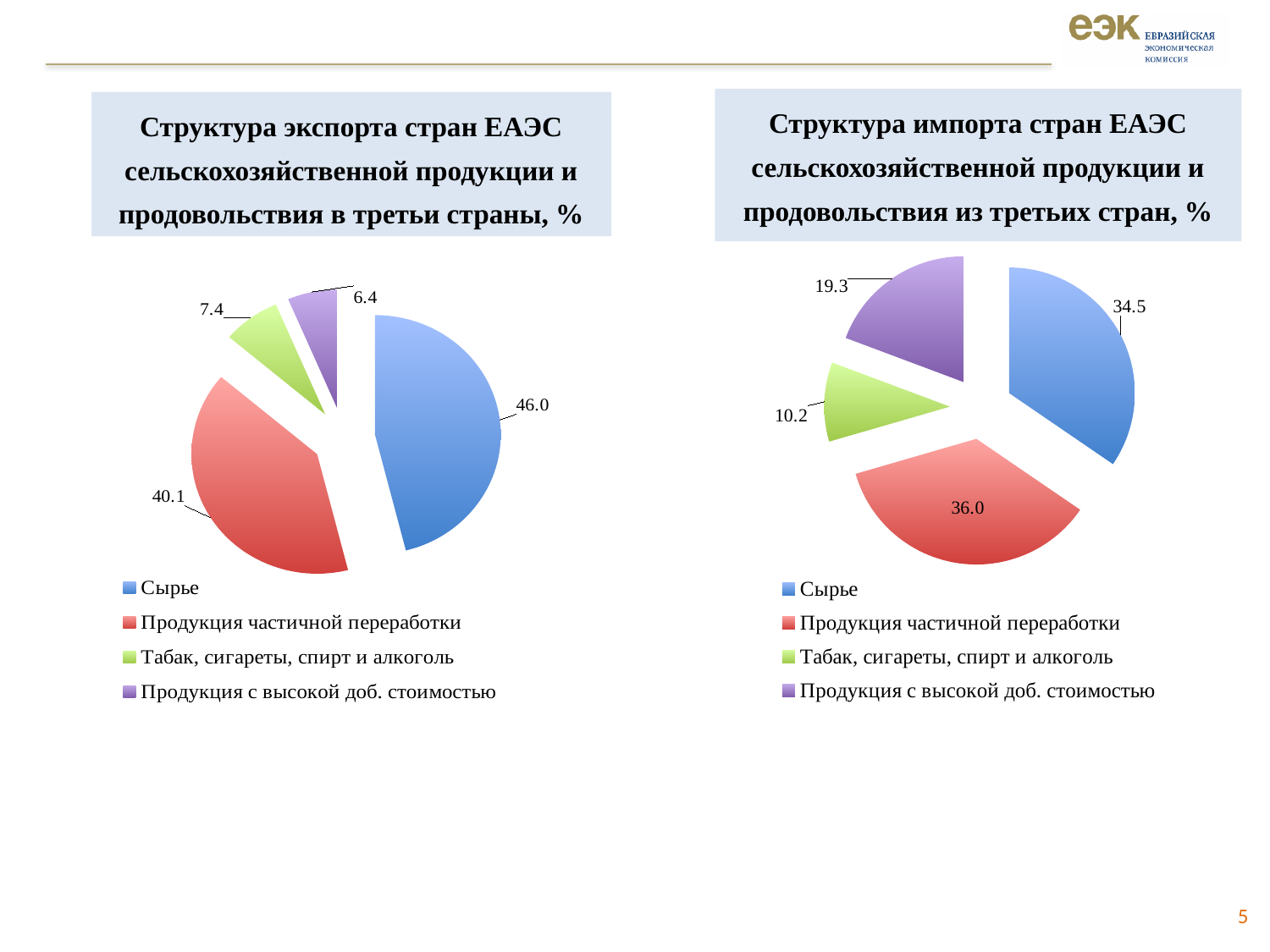
In the right chart (import structure), which category has the smallest slice? Табак, сигареты, спирт и алкоголь In the left chart (export structure), which category has the largest slice? Сырье How many categories does the legend of the left chart (export structure) list? 4 In the right chart (import structure), what is the difference between the values for Продукция с высокой доб. стоимостью and Табак, сигареты, спирт и алкоголь? 9.1 In the right chart (import structure), what is the value for Продукция частичной переработки? 36.0 In the right chart (import structure), what is the value for Табак, сигареты, спирт и алкоголь? 10.2 In the right chart (import structure), which is larger: Сырье or Продукция частичной переработки? Продукция частичной переработки What type of chart is used on the right side of the slide (import structure)? Pie chart In the left chart (export structure), what is the difference between the values for Сырье and Продукция частичной переработки? 5.9 In the left chart (export structure), what is the value for Продукция с высокой доб. стоимостью? 6.4 What is the title of the left chart? Структура экспорта стран ЕАЭС сельскохозяйственной продукции и продовольствия в третьи страны, % In the left chart (export structure), what is the value for Сырье? 46.0